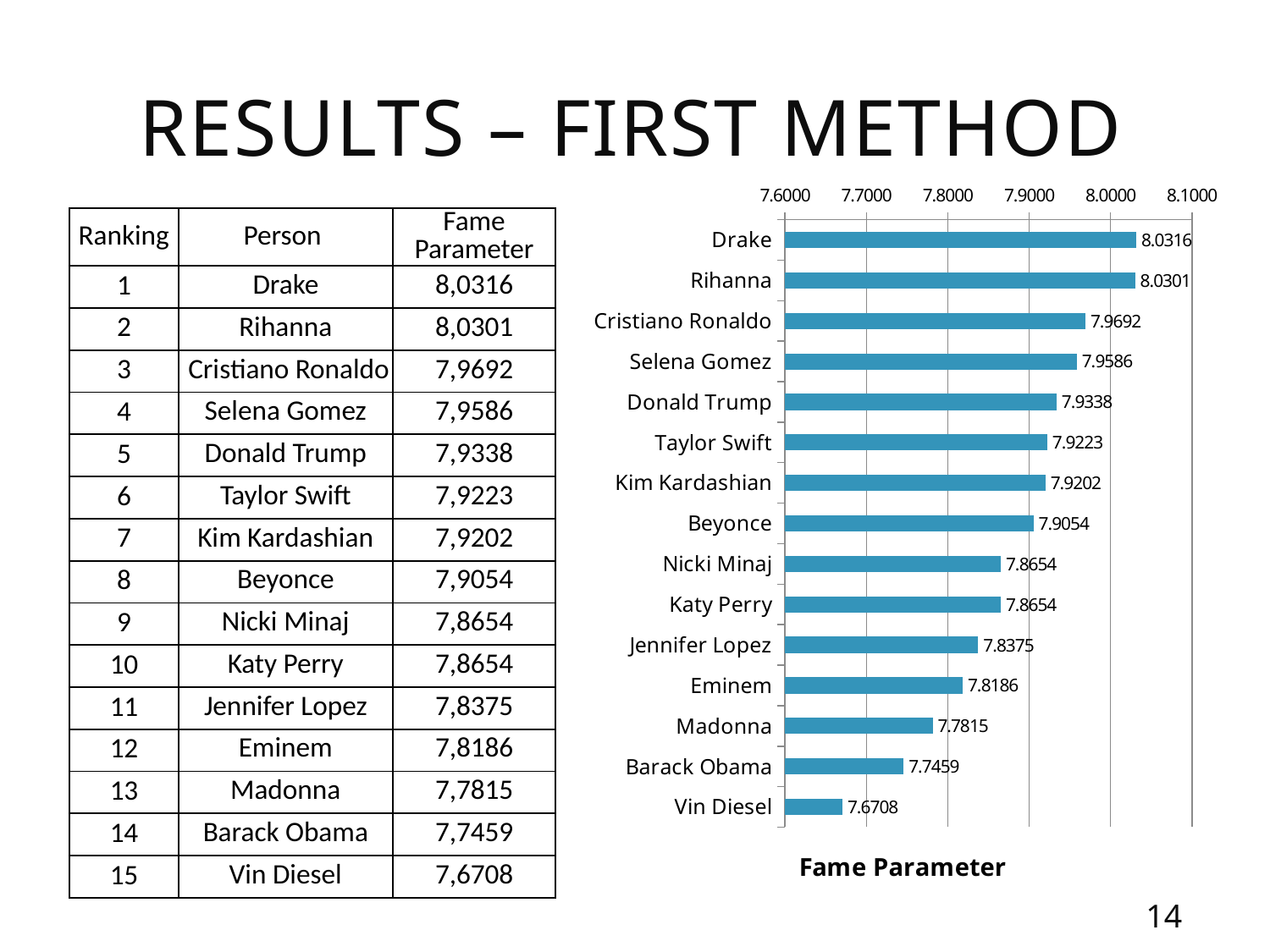
Is the Fame Parameter value for Madonna greater or less than 7.8000? less What is the Fame Parameter value for Jennifer Lopez in the chart? 7.8375 Which person has the highest Fame Parameter in the chart? Drake Who has a larger Fame Parameter in the chart, Donald Trump or Eminem? Donald Trump How many people are shown in the chart? 15 What is the Fame Parameter value for Cristiano Ronaldo in the chart? 7.9692 What type of chart is shown on the slide? bar chart Which person has the lowest Fame Parameter in the chart? Vin Diesel What is the difference between the Fame Parameter of Drake and Vin Diesel in the chart? 0.3608 What is the Fame Parameter value for Barack Obama in the chart? 7.7459